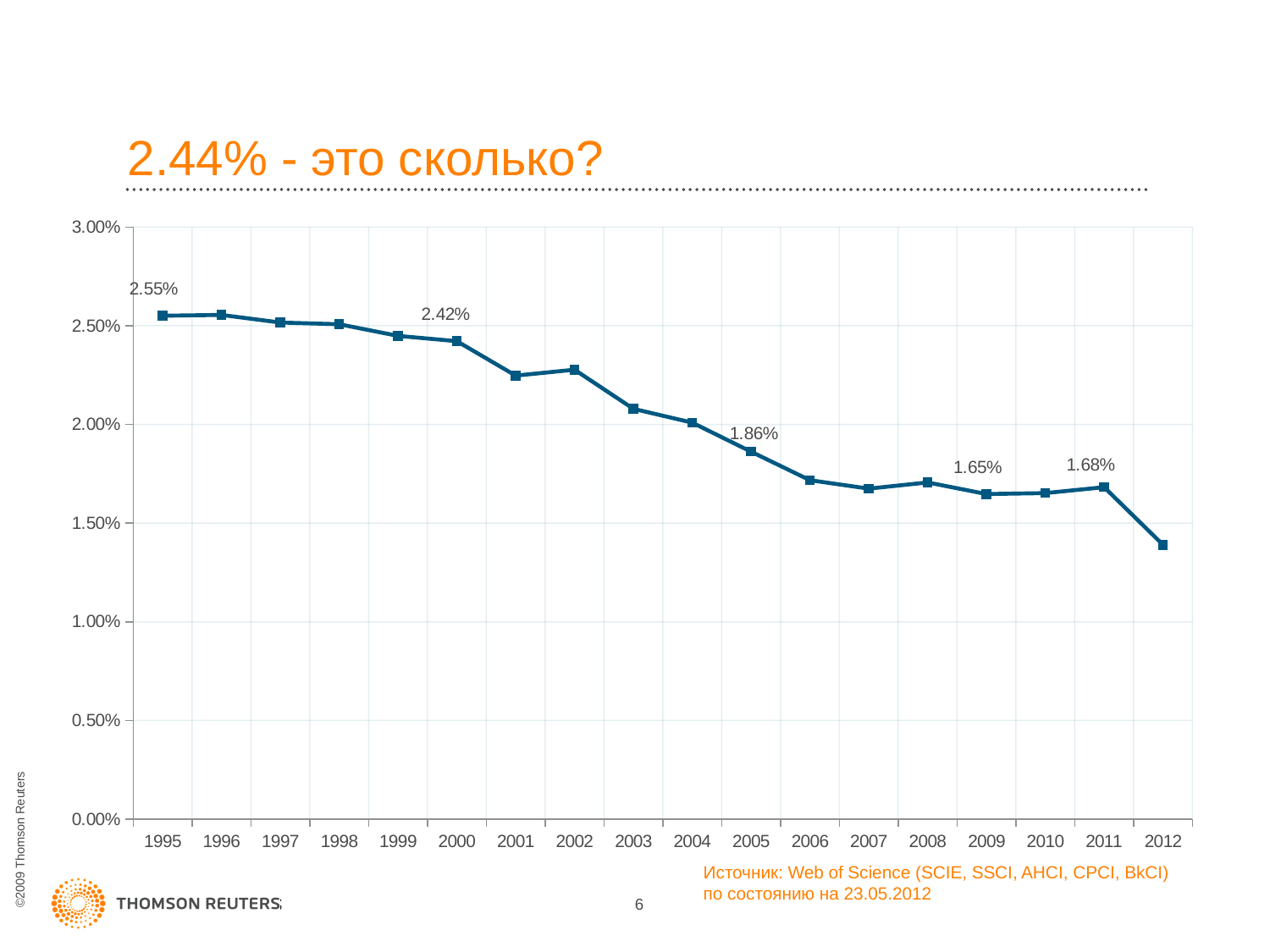
What is the value for 2005? 1.86% What is the value for 2000? 2.42% What is the value for 1995? 2.55% Which year has the lowest value? 2012 What is the value for 2009? 1.65% How many years are plotted on the x axis? 18 Is the value for 2012 greater or less than 1.50%? less What is the difference between the values for 1995 and 2000? 0.13% Which year has the larger value, 2009 or 2011? 2011 What is the value for 2011? 1.68% What is the difference between the values for 2005 and 2009? 0.21% Is the value for 2003 greater or less than 2.00%? greater